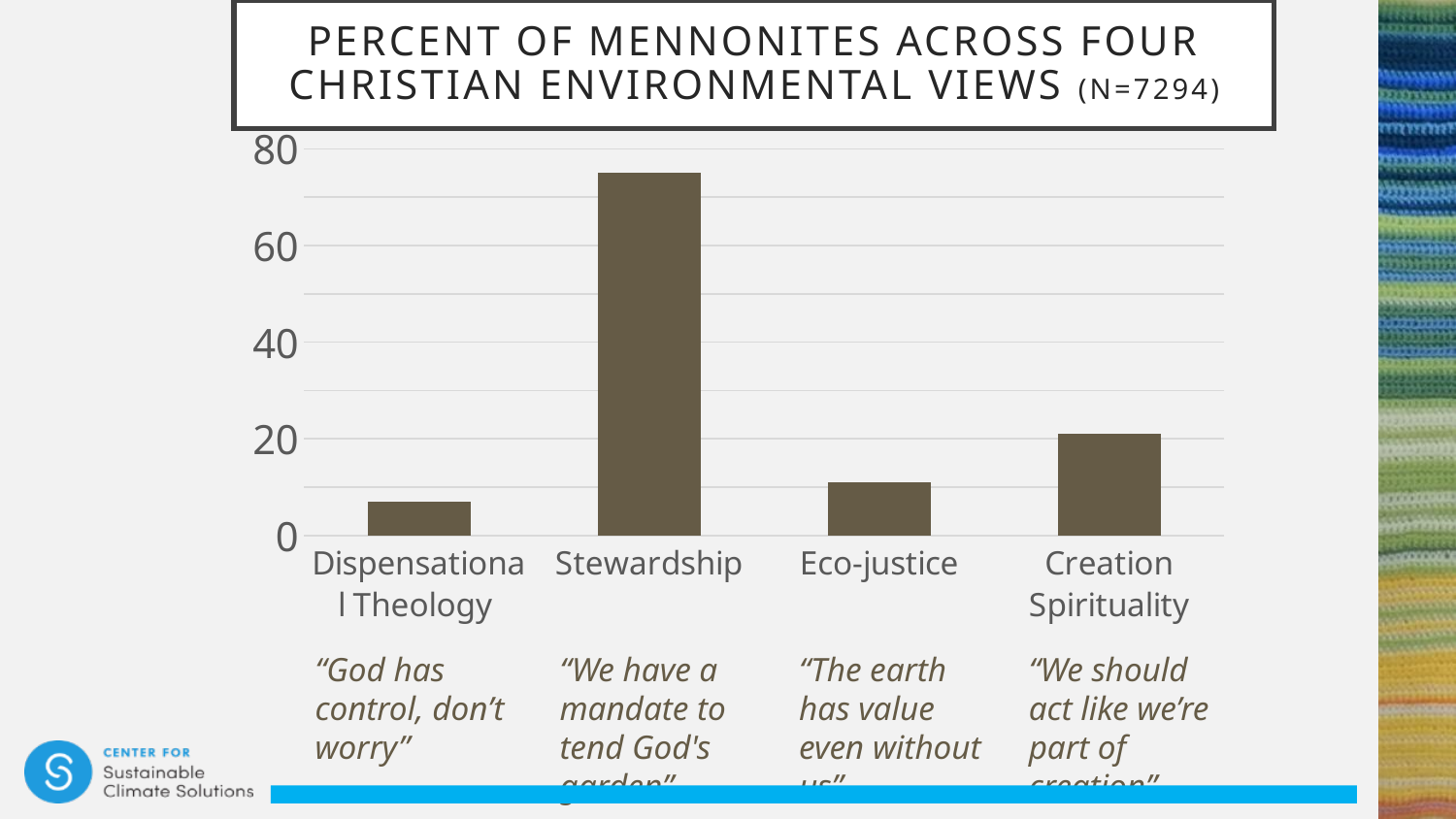
Which environmental view has the highest percentage of Mennonites? Stewardship What kind of chart is shown on the slide? Bar chart What is the sample size (N) given in the chart title? 7294 Is the value for Creation Spirituality greater or less than 40? less Is the value for Stewardship greater or less than 60? greater What is the highest value shown on the y axis? 80 Which environmental view has the lowest percentage of Mennonites? Dispensational Theology Is the value for Eco-justice greater or less than 20? less Which has a higher value, Stewardship or Creation Spirituality? Stewardship Which has a higher value, Creation Spirituality or Eco-justice? Creation Spirituality How many categories (environmental views) are shown on the x axis? 4